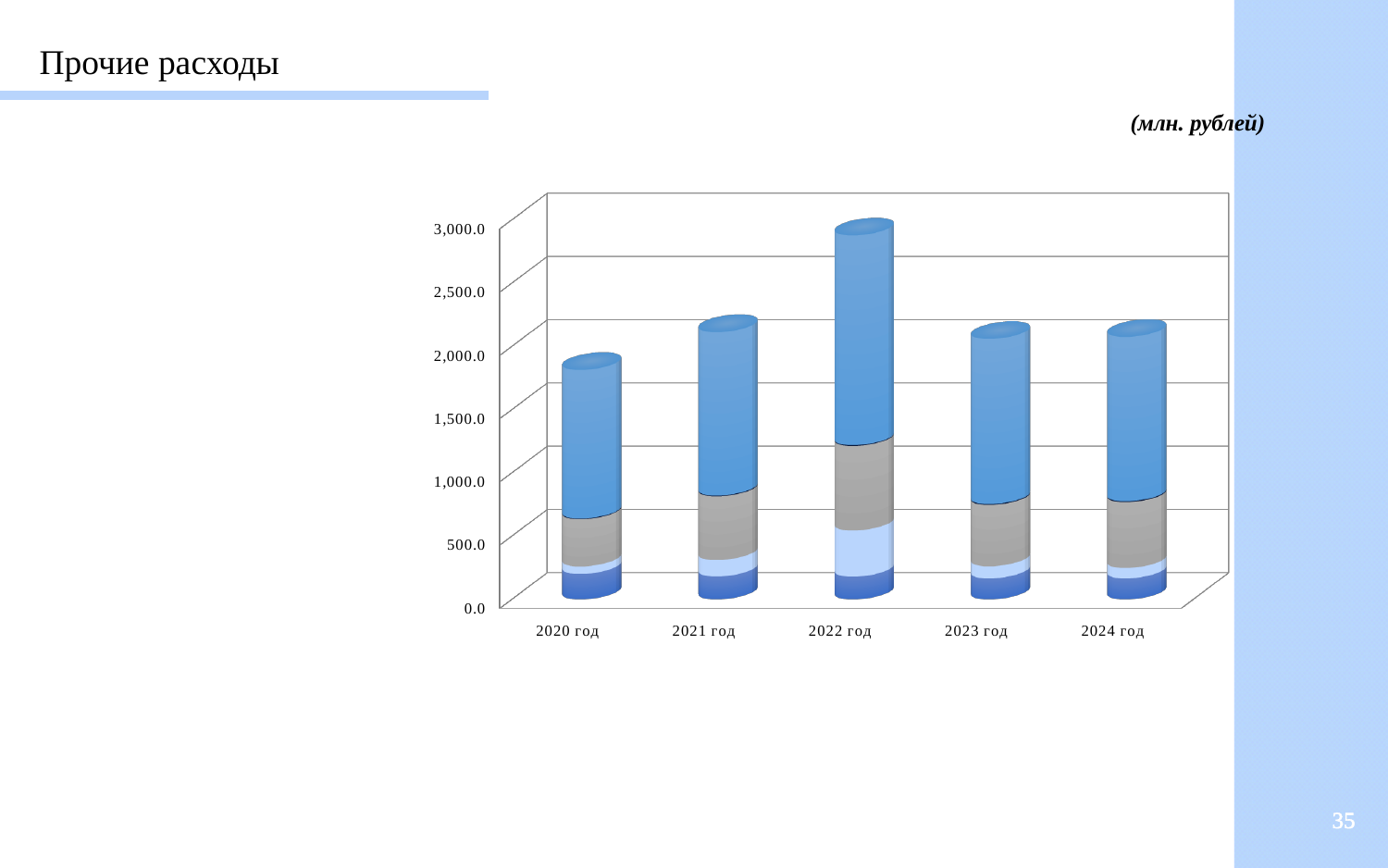
Is the total for 2023 год greater or less than 3,000.0? less How many years (categories) are shown on the x axis of the chart? 5 Is the total for 2020 год greater or less than 2,500.0? less Which year has the highest total bar in the chart? 2022 год Which total is larger, 2021 год or 2022 год? 2022 год What kind of chart is shown on the slide? Stacked bar chart Is the total for 2021 год greater or less than 1,500.0? greater Which year has the lowest total bar in the chart? 2020 год Which total is larger, 2020 год or 2022 год? 2022 год What unit of measurement is indicated for the chart on the slide? млн. рублей